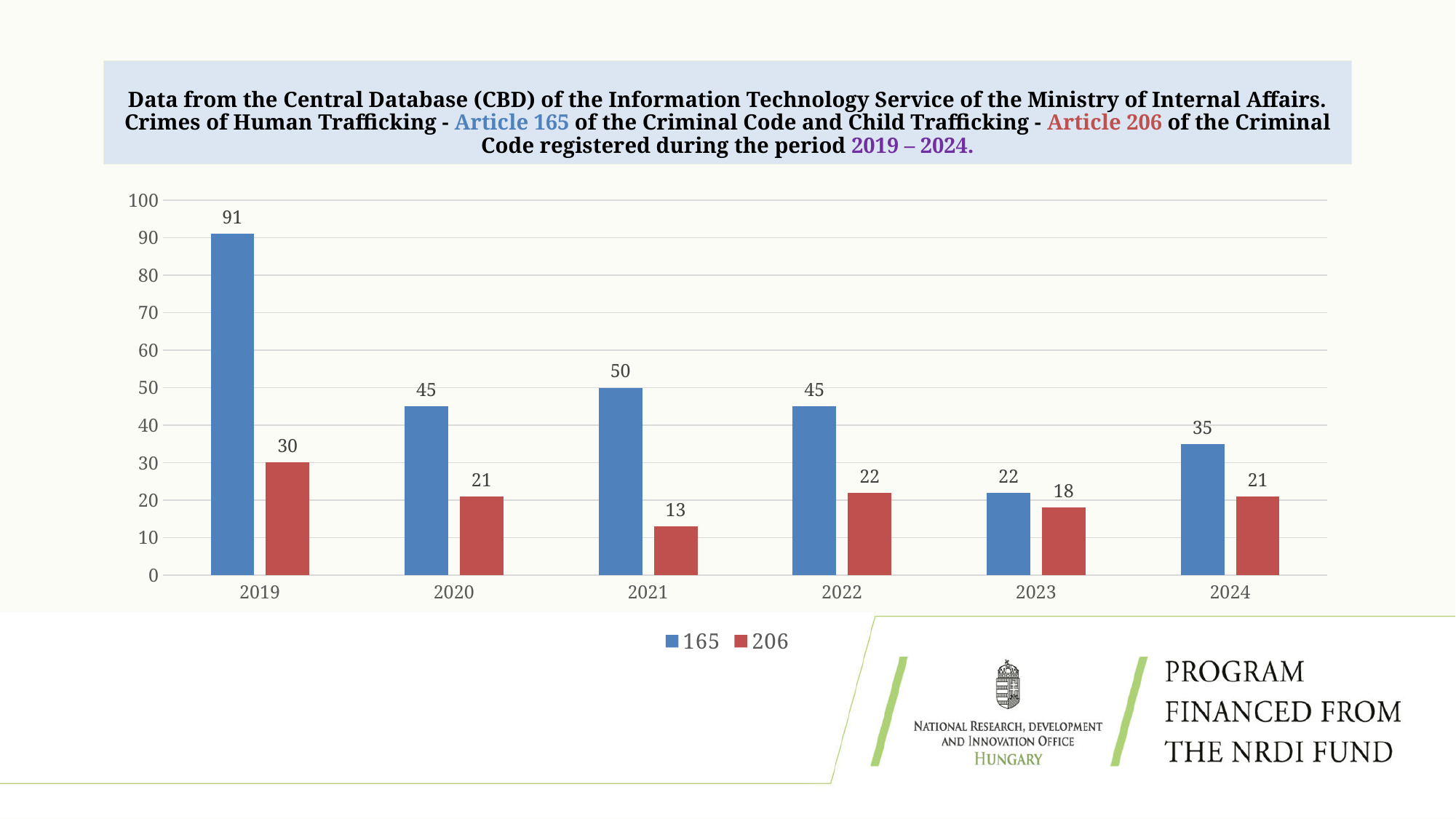
What is the value for series 165 in 2019? 91 In which year is the value for series 206 lowest? 2021 Which is larger in 2023: the value for 165 or the value for 206? 165 Does the value for series 165 rise or fall from 2019 to 2020? fall What is the value for series 206 in 2021? 13 How many series does the legend list? 2 What kind of chart is shown on the slide? bar chart What colour are the bars for series 206? red In which year is the value for series 165 highest? 2019 How many years are shown on the x axis? 6 What is the difference between the 165 and 206 values in 2019? 61 What is the value for series 165 in 2024? 35